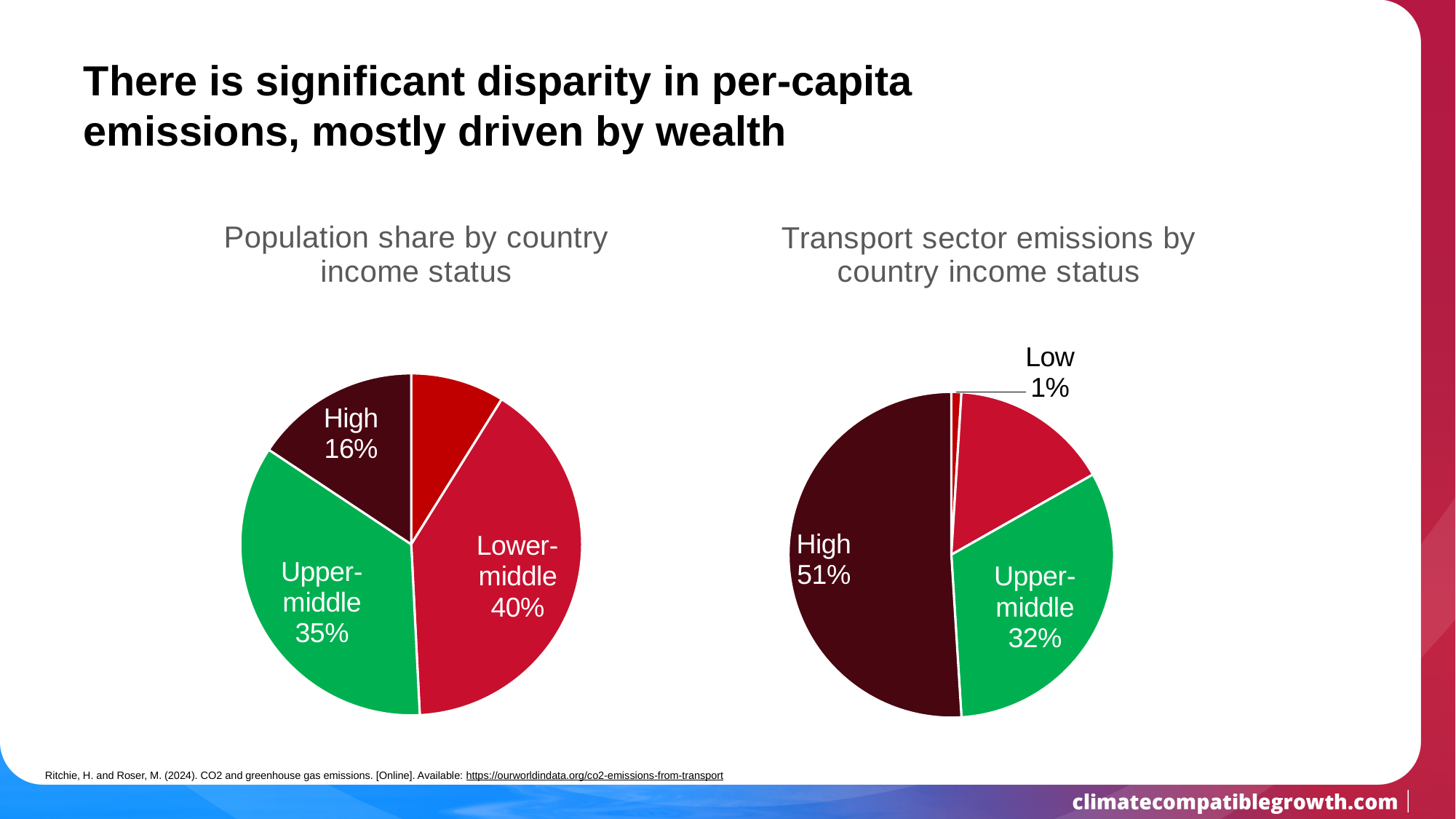
In the 'Transport sector emissions by country income status' chart, which category has the smallest share? Low In the 'Transport sector emissions by country income status' chart, what is the share for Low? 1% In the 'Population share by country income status' chart, what is the share for High? 16% How many slices does the 'Transport sector emissions by country income status' pie chart have? 4 Which is larger: the High share in the 'Population share by country income status' chart or the High share in the 'Transport sector emissions by country income status' chart? Transport sector emissions (51%) In the 'Transport sector emissions by country income status' chart, what is the share for Upper-middle? 32% In the 'Transport sector emissions by country income status' chart, what is the share for High? 51% In the 'Population share by country income status' chart, which labelled category has the largest share? Lower-middle What kind of chart is used for 'Population share by country income status'? Pie chart In the 'Population share by country income status' chart, what is the difference between the Lower-middle and High shares? 24 percentage points In the 'Population share by country income status' chart, what is the share for Lower-middle? 40% In the 'Population share by country income status' chart, what is the share for Upper-middle? 35%